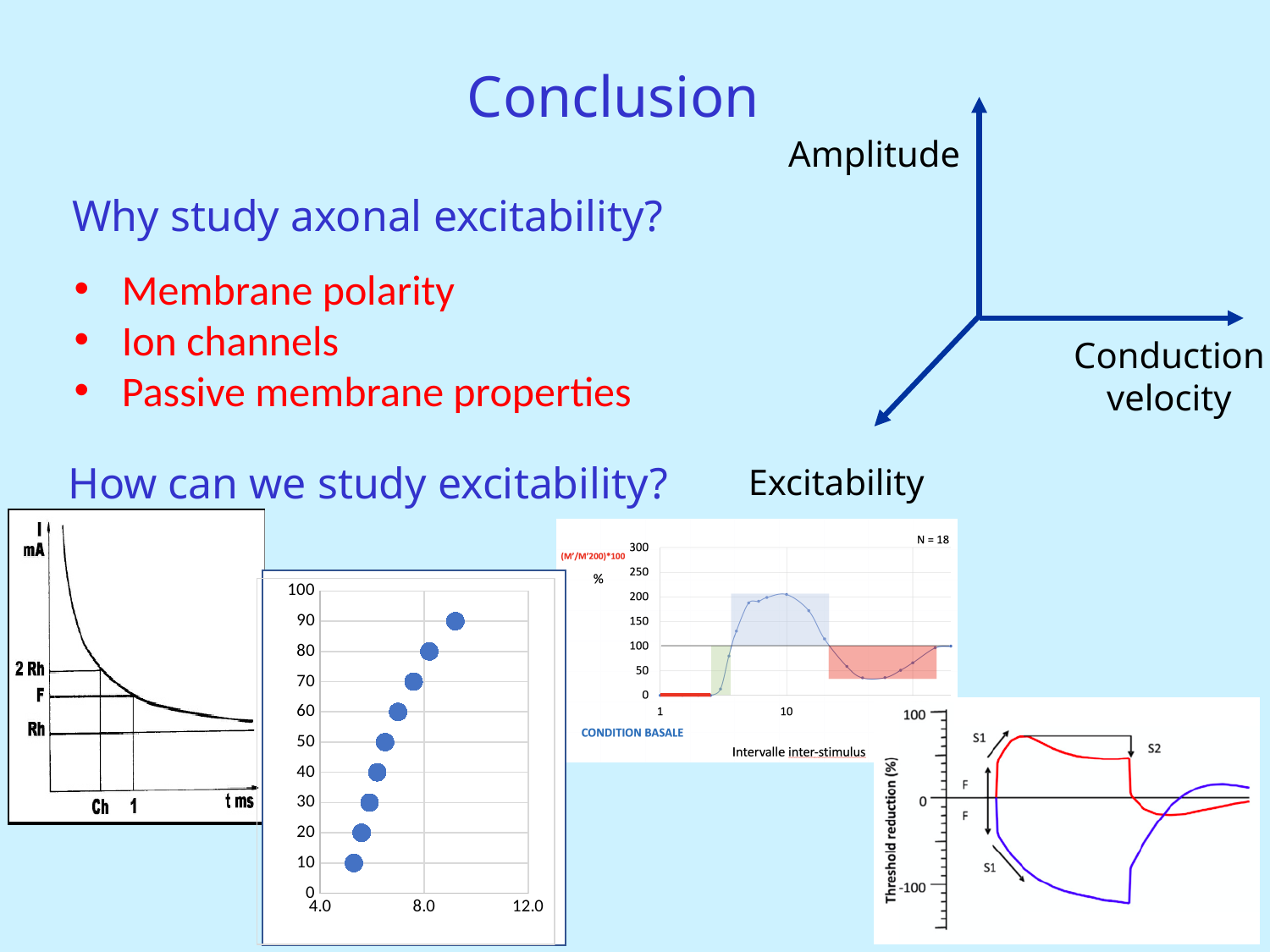
In the blue-dot scatter chart, what is the lowest y value of a point? 10 In the blue-dot scatter chart, is the x value of the point at y = 60 greater or less than 8.0? less What kind of chart is the blue-dot chart in the lower left-centre of the slide? scatter chart How many data points are plotted in the blue-dot scatter chart? 9 In the blue-dot scatter chart, what is the highest y value reached by a point? 90 In the blue-dot scatter chart, do the y values rise or fall as x increases? rise In the blue-dot scatter chart, what are the three tick labels shown on the x axis? 4.0, 8.0, 12.0 In the 'CONDITION BASALE' chart on the right, what sample size N is stated? N = 18 In the 'CONDITION BASALE' chart on the right, what is the maximum value shown on the y axis? 300 In the blue-dot scatter chart, what is the maximum value shown on the y axis? 100 In the blue-dot scatter chart, is the x value of the point at y = 10 greater or less than 8.0? less In the blue-dot scatter chart, is the x value of the point at y = 90 greater or less than 8.0? greater